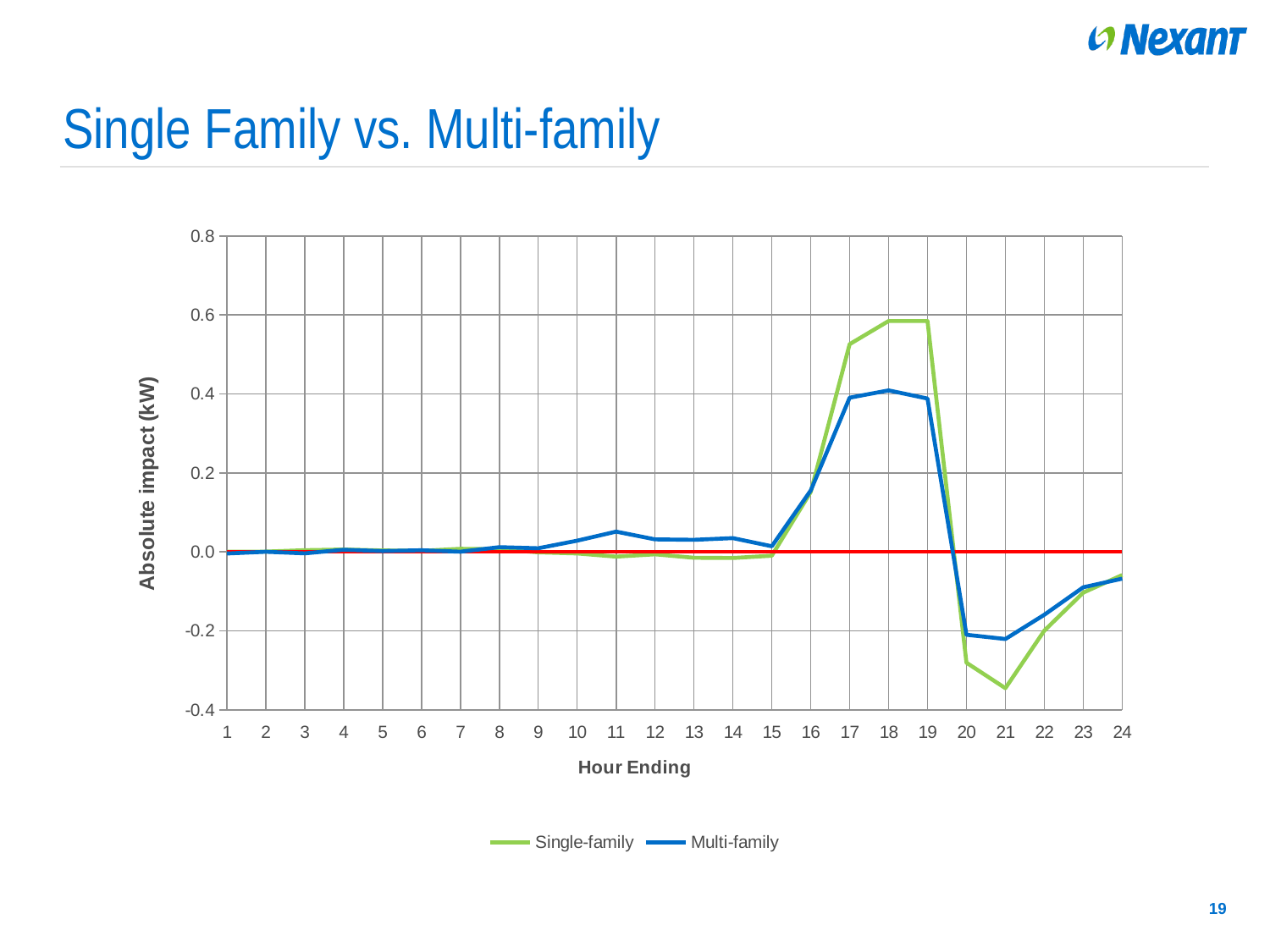
Is the Single-family value at hour 18 greater or less than 0.4? greater What is the label of the y axis? Absolute impact (kW) How many series does the legend list? 2 Is the Single-family value at hour 21 greater or less than -0.2? less At hour 21, which series has the lower value, Single-family or Multi-family? Single-family Is the Multi-family value at hour 17 greater or less than 0.2? greater What kind of chart is shown on the slide? Line chart At which hour does the Single-family series reach its lowest value? 21 At hour 18, which series has the higher value, Single-family or Multi-family? Single-family How many hours are plotted along the x axis? 24 Does the Single-family series rise or fall from hour 19 to hour 21? Fall